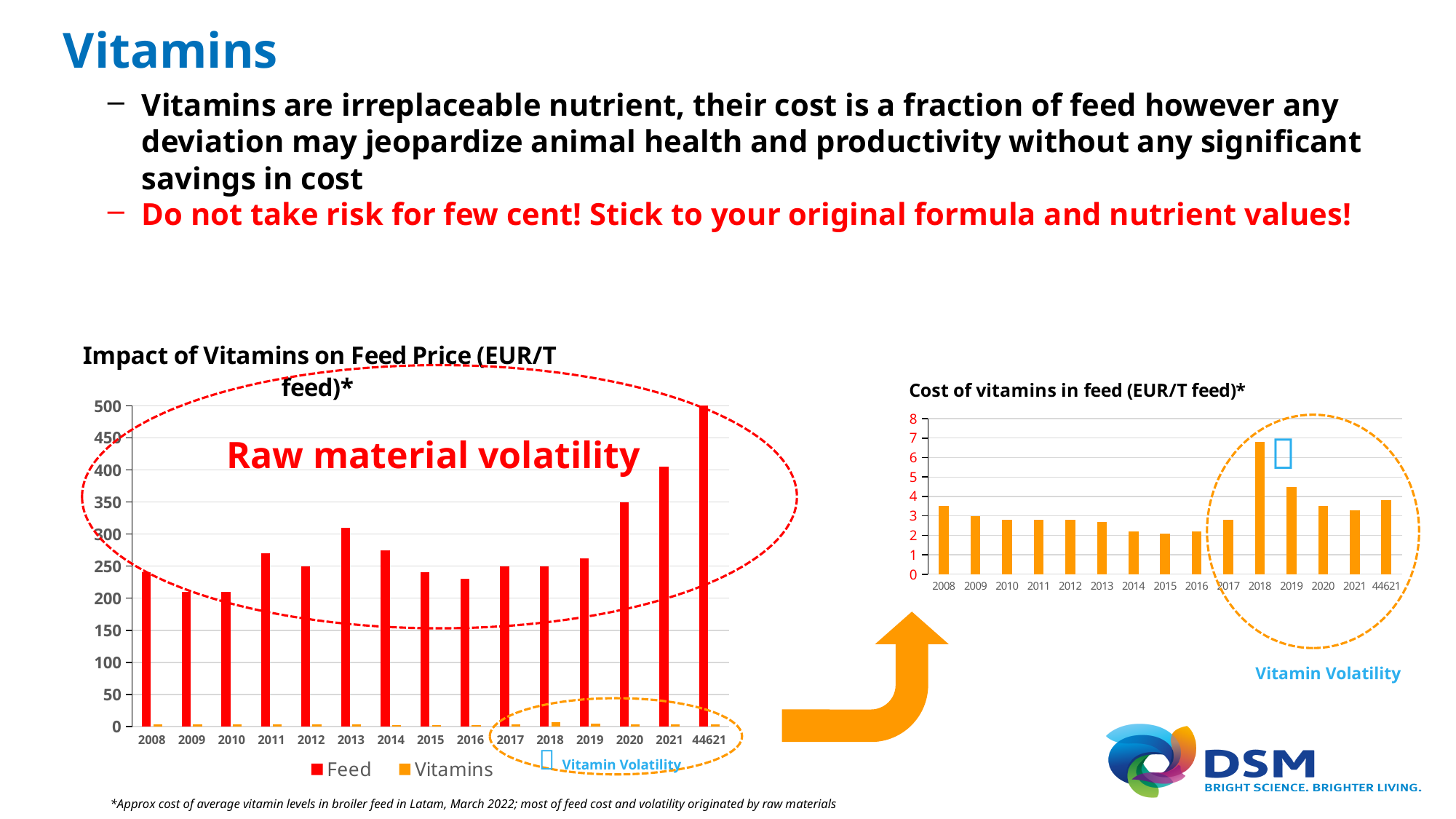
In the left chart 'Impact of Vitamins on Feed Price (EUR/T feed)*', is the Feed value for 44621 greater or less than 450? greater In the right chart 'Cost of vitamins in feed (EUR/T feed)*', is the value for 2015 greater or less than 3? less What colour are the Vitamins bars in the left chart 'Impact of Vitamins on Feed Price (EUR/T feed)*'? Orange In the right chart 'Cost of vitamins in feed (EUR/T feed)*', is the value for 2018 greater or less than 6? greater In the left chart 'Impact of Vitamins on Feed Price (EUR/T feed)*', which category has the highest Feed value? 44621 In the right chart 'Cost of vitamins in feed (EUR/T feed)*', which is larger, the value for 2018 or for 2019? 2018 In the left chart 'Impact of Vitamins on Feed Price (EUR/T feed)*', which is larger, the Feed value for 2021 or for 2020? 2021 How many series does the legend of the left chart 'Impact of Vitamins on Feed Price (EUR/T feed)*' list? 2 How many categories are shown on the x axis of the left chart 'Impact of Vitamins on Feed Price (EUR/T feed)*'? 15 In the right chart 'Cost of vitamins in feed (EUR/T feed)*', which category has the highest value? 2018 What kind of chart is the 'Impact of Vitamins on Feed Price (EUR/T feed)*' chart on the left? Bar chart